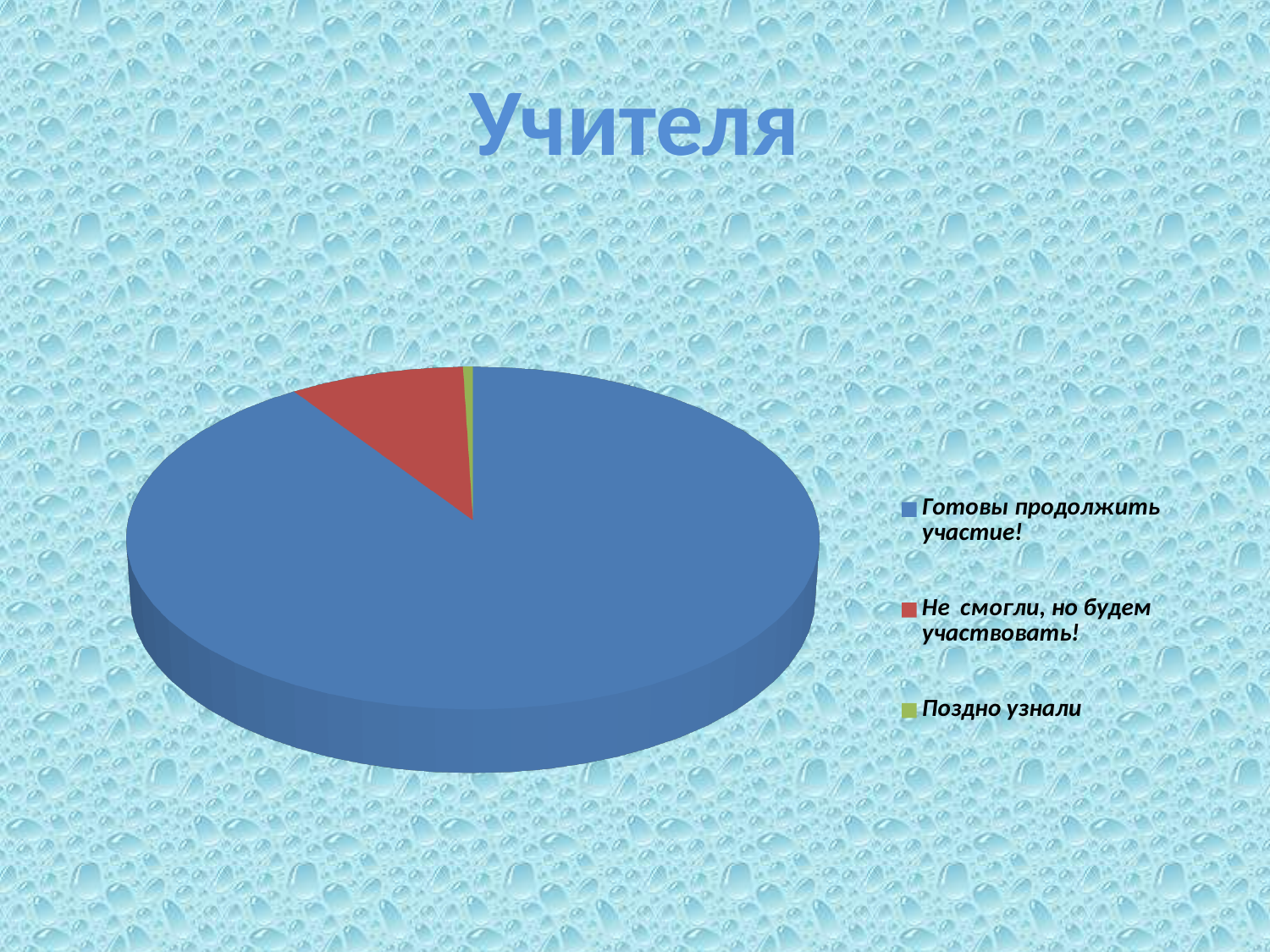
How many entries does the legend of the pie chart list? 3 How many slices does the pie chart have? 3 What colour is the slice for "Не смогли, но будем участвовать!" in the pie chart? red Which slice is larger: "Не смогли, но будем участвовать!" or "Поздно узнали"? Не смогли, но будем участвовать! What is the title of the slide with the pie chart? Учителя Which slice is larger: "Готовы продолжить участие!" or "Не смогли, но будем участвовать!"? Готовы продолжить участие! What kind of chart is shown on the slide? pie chart Which category has the largest slice of the pie chart? Готовы продолжить участие! Which category has the smallest slice of the pie chart? Поздно узнали